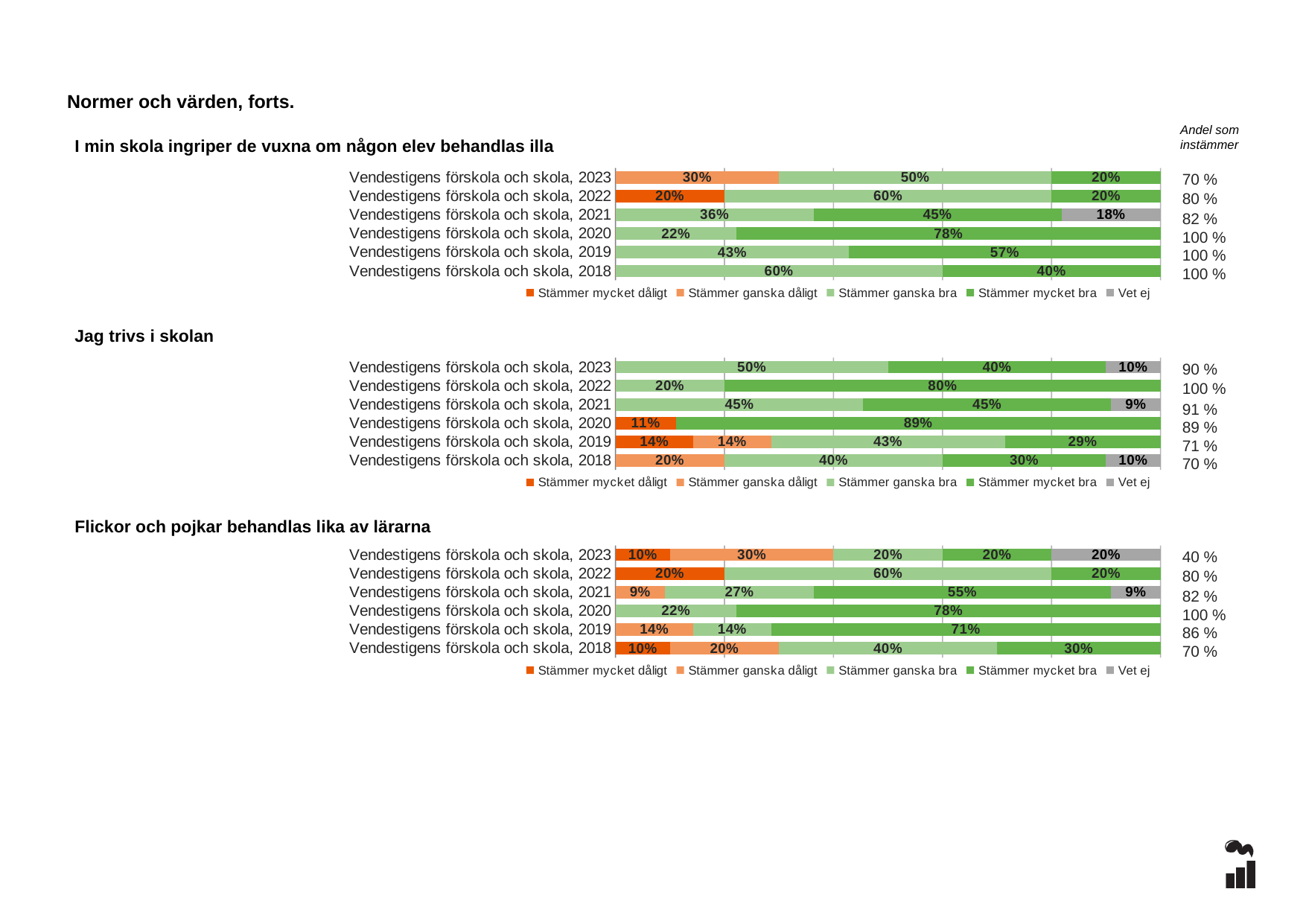
How many series does the legend list for the chart 'Jag trivs i skolan'? 5 In the chart 'Jag trivs i skolan', what is the 'Stämmer mycket bra' value for Vendestigens förskola och skola, 2022? 80% How many bars (years) are shown in the chart 'Flickor och pojkar behandlas lika av lärarna'? 6 In the chart 'Jag trivs i skolan', what is the difference between the 'Stämmer mycket bra' values for 2020 and 2019? 60% In the chart 'Jag trivs i skolan', which is larger: the 'Stämmer ganska bra' value for 2023 or for 2021? 2023 In the chart 'Flickor och pojkar behandlas lika av lärarna', what is the 'Stämmer mycket bra' value for Vendestigens förskola och skola, 2019? 71% In the chart 'I min skola ingriper de vuxna om någon elev behandlas illa', which year has the highest 'Stämmer ganska bra' value? Vendestigens förskola och skola, 2022 and 2018 (tie at 60%) In the chart 'Flickor och pojkar behandlas lika av lärarna', what is the 'Stämmer ganska dåligt' value for Vendestigens förskola och skola, 2023? 30% In the chart 'I min skola ingriper de vuxna om någon elev behandlas illa', what is the 'Vet ej' value for Vendestigens förskola och skola, 2021? 18% In the chart 'I min skola ingriper de vuxna om någon elev behandlas illa', what is the 'Stämmer mycket bra' value for Vendestigens förskola och skola, 2020? 78% In the chart 'Flickor och pojkar behandlas lika av lärarna', which year has the lowest 'Stämmer mycket bra' value? Vendestigens förskola och skola, 2023 and 2022 (tie at 20%) What kind of chart is 'I min skola ingriper de vuxna om någon elev behandlas illa'? Stacked bar chart